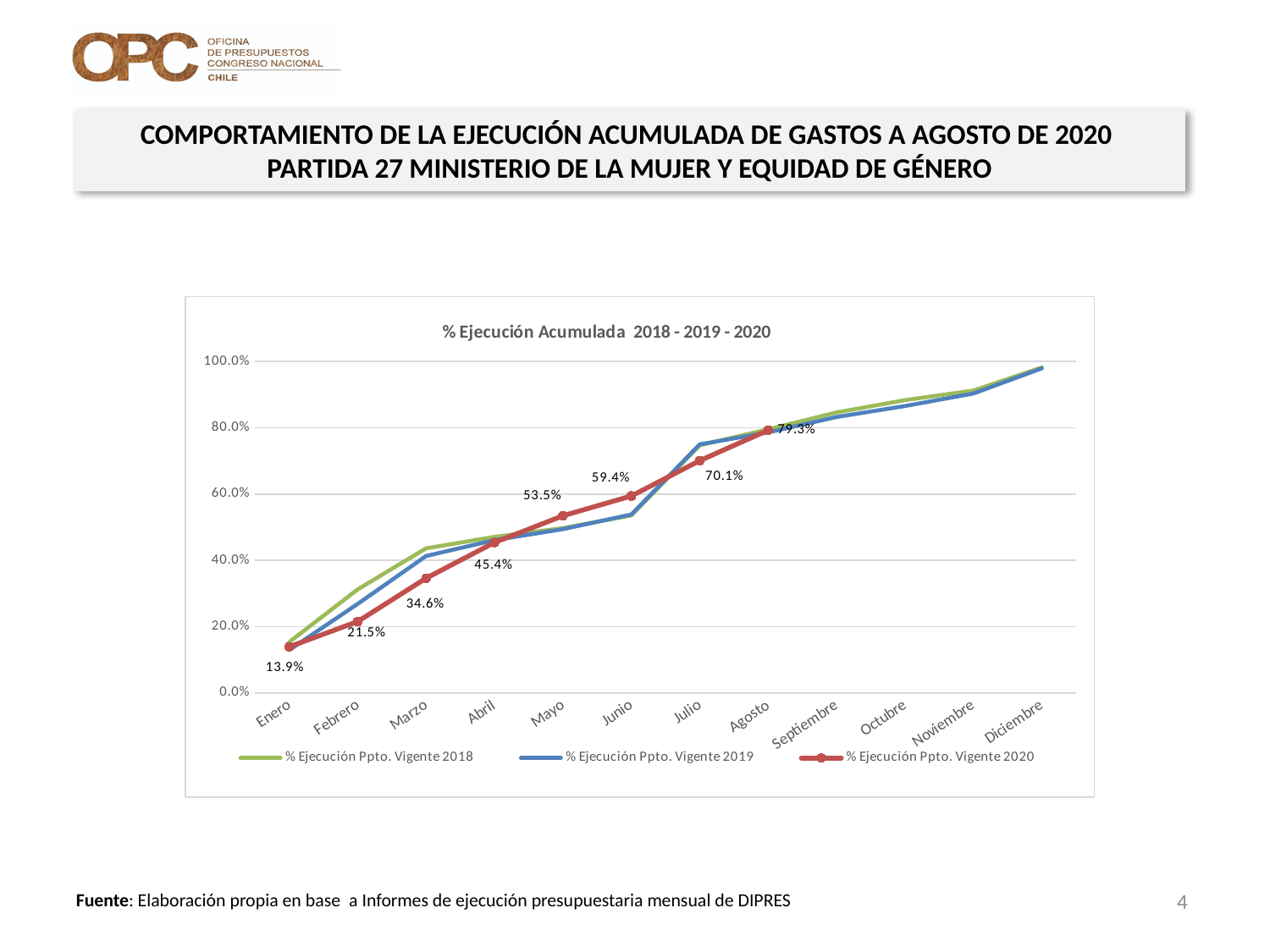
How many series does the legend list? 3 Is the value for % Ejecución Ppto. Vigente 2019 in Julio greater or less than 60.0%? greater What is the difference between the % Ejecución Ppto. Vigente 2020 values for Julio and Junio? 10.7% Which month has the lowest labelled value for % Ejecución Ppto. Vigente 2020? Enero What is the difference between the % Ejecución Ppto. Vigente 2020 values for Agosto and Enero? 65.4% How many months are shown on the x axis? 12 What is the value for % Ejecución Ppto. Vigente 2020 in Junio? 59.4% What kind of chart is shown on the slide? Line chart What is the value for % Ejecución Ppto. Vigente 2020 in Enero? 13.9% What is the value for % Ejecución Ppto. Vigente 2020 in Agosto? 79.3% What is the value for % Ejecución Ppto. Vigente 2020 in Abril? 45.4% Which month has the highest labelled value for % Ejecución Ppto. Vigente 2020? Agosto